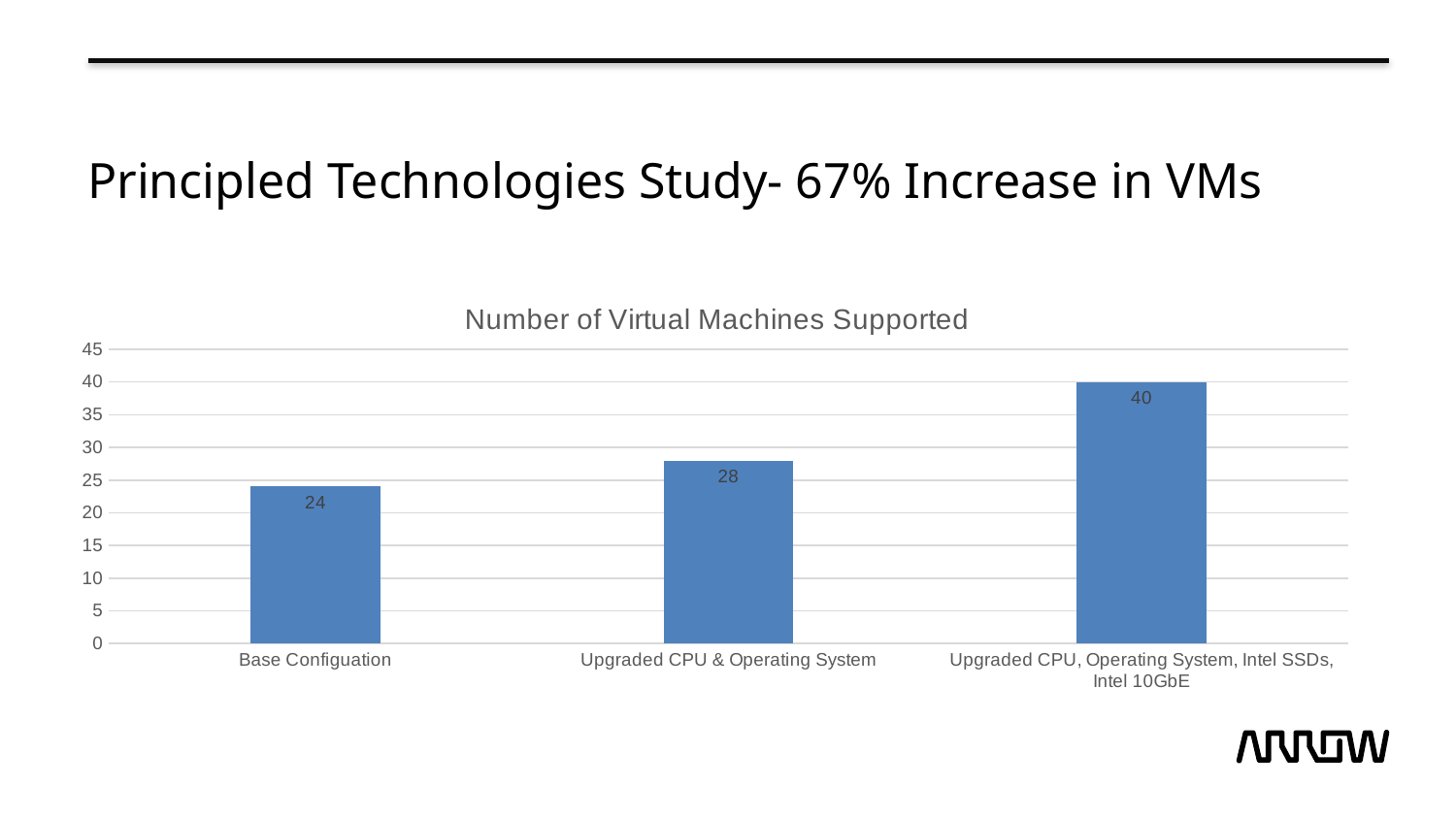
What is the difference in virtual machines supported between Upgraded CPU & Operating System and the Base Configuation? 4 What kind of chart is shown on the slide? bar chart What is the number of virtual machines supported for Upgraded CPU, Operating System, Intel SSDs, Intel 10GbE? 40 Is the value for Upgraded CPU & Operating System greater or less than 30? less What is the number of virtual machines supported for the Base Configuation? 24 What is the title of the chart? Number of Virtual Machines Supported What is the difference in virtual machines supported between the Upgraded CPU, Operating System, Intel SSDs, Intel 10GbE configuration and the Base Configuation? 16 Which configuration supports the highest number of virtual machines? Upgraded CPU, Operating System, Intel SSDs, Intel 10GbE Which configuration supports the lowest number of virtual machines? Base Configuation Which supports more virtual machines: Base Configuation or Upgraded CPU & Operating System? Upgraded CPU & Operating System How many configurations are shown in the chart? 3 What is the number of virtual machines supported for Upgraded CPU & Operating System? 28